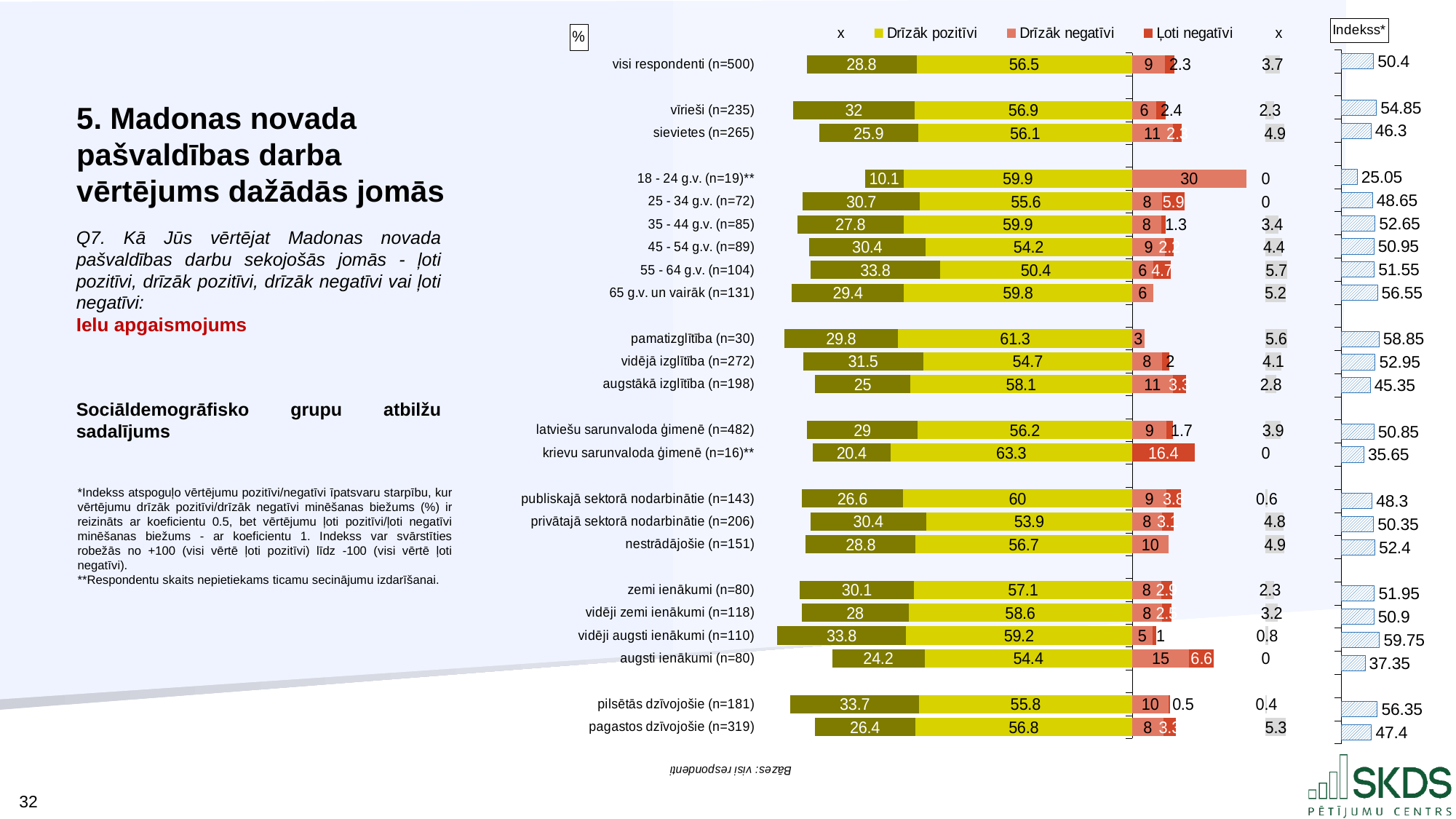
How many respondent groups (categories) are shown in the chart? 23 What is the Indekss* value for 'pilsētās dzīvojošie (n=181)'? 56.35 Which group has the highest 'Drīzāk pozitīvi' value? krievu sarunvaloda ģimenē (n=16)** What is the difference between the Indekss* values for 'vīrieši (n=235)' and 'sievietes (n=265)'? 8.55 What is the Indekss* value for 'krievu sarunvaloda ģimenē (n=16)**'? 35.65 What is the 'Drīzāk pozitīvi' value for 'visi respondenti (n=500)'? 56.5 Which group has the highest Indekss* value? vidēji augsti ienākumi (n=110) Which group has the lowest Indekss* value? 18 - 24 g.v. (n=19)** What is the 'Drīzāk negatīvi' value for the '18 - 24 g.v. (n=19)**' group? 30 Which area of municipal work is evaluated on this slide (shown in red under the question text)? Ielu apgaismojums Which has a larger 'Drīzāk pozitīvi' value: 'pamatizglītība (n=30)' or 'augstākā izglītība (n=198)'? pamatizglītība (n=30) What kind of chart is used to show the response shares by group? bar chart